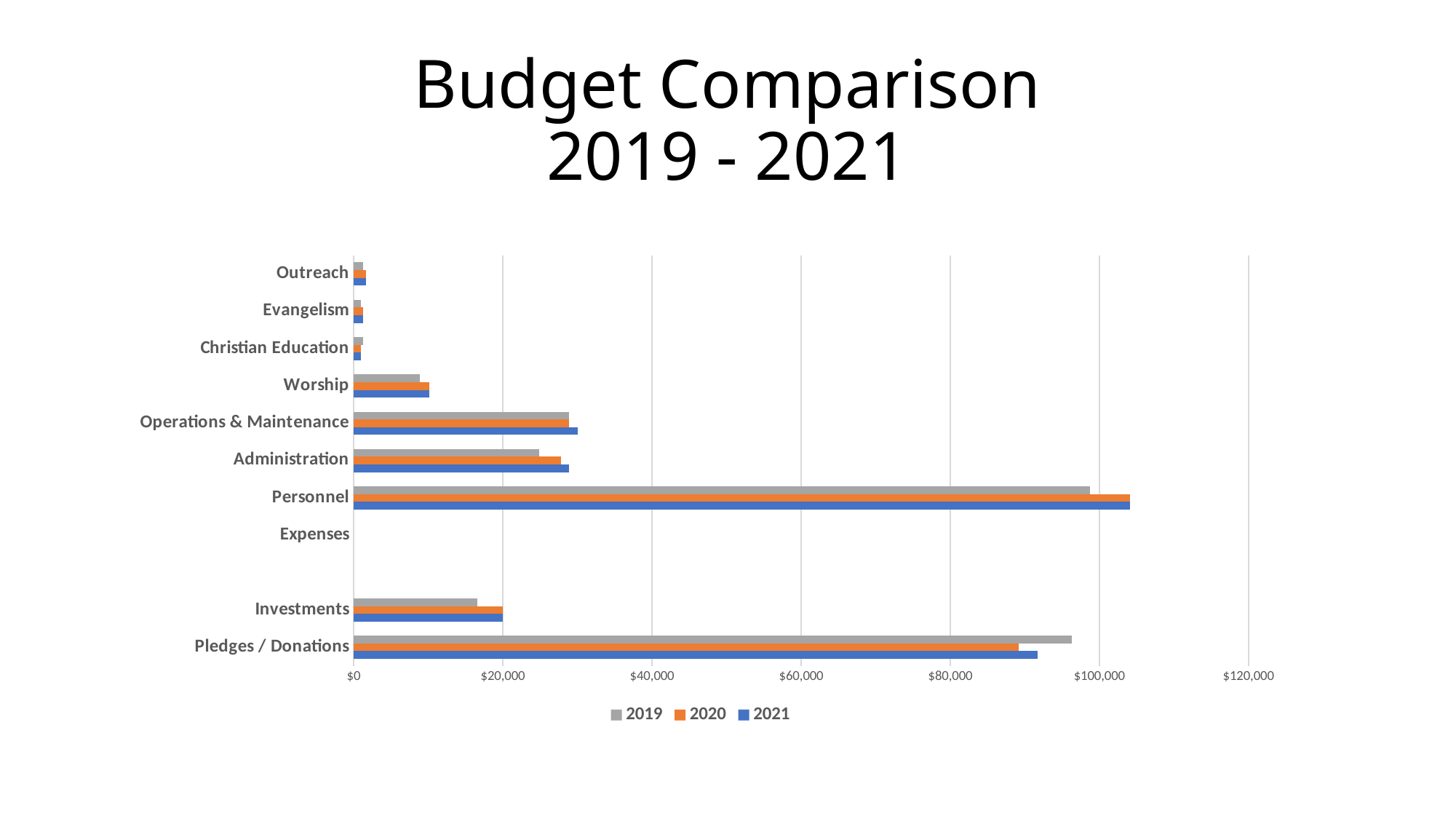
What is the title of the chart on the slide? Budget Comparison 2019 - 2021 Is the value for Worship in 2019 greater or less than $20,000? less Is the value for Investments in 2019 greater or less than $20,000? less Is the value for Pledges / Donations in 2019 greater or less than $100,000? less Which category has the highest value for 2021? Personnel Which is larger for Investments: the 2019 value or the 2021 value? 2021 Which is larger for Pledges / Donations: the 2019 value or the 2020 value? 2019 Which series is shown in orange in the legend? 2020 What kind of chart is shown on the slide? Bar chart How many series does the legend list? 3